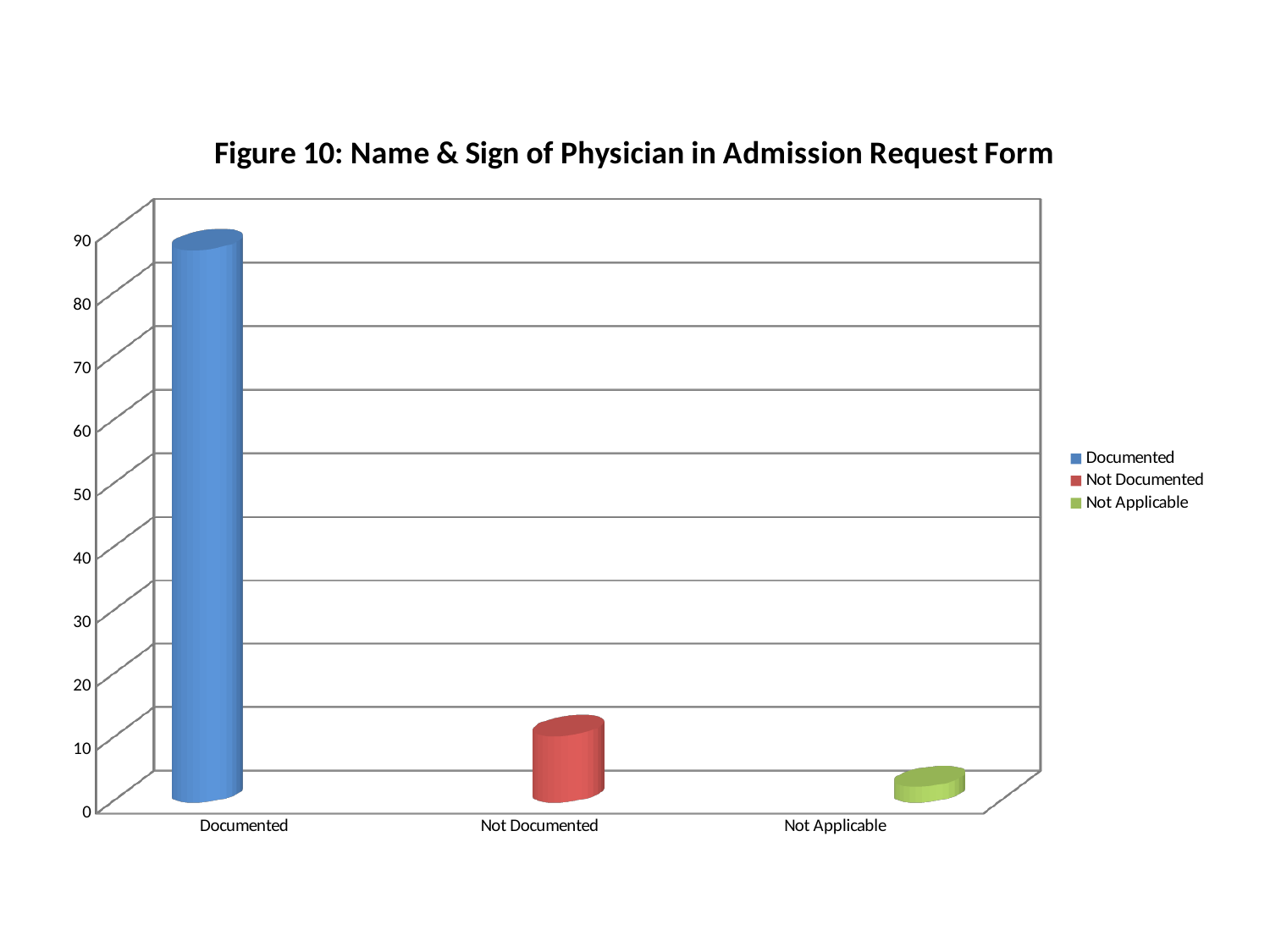
Is the value for Not Applicable greater or less than 10? less Is the value for Not Documented greater or less than 20? less How many entries does the legend list? 3 Do the values rise or fall from left to right along the x axis? fall What colour is the bar for Documented? blue Which category has the highest value? Documented Which is larger, the value for Documented or the value for Not Documented? Documented How many categories are shown on the x axis? 3 What is the title of the chart? Figure 10: Name & Sign of Physician in Admission Request Form What kind of chart is shown on the slide? bar chart Is the value for Documented greater or less than 80? greater Which category has the lowest value? Not Applicable